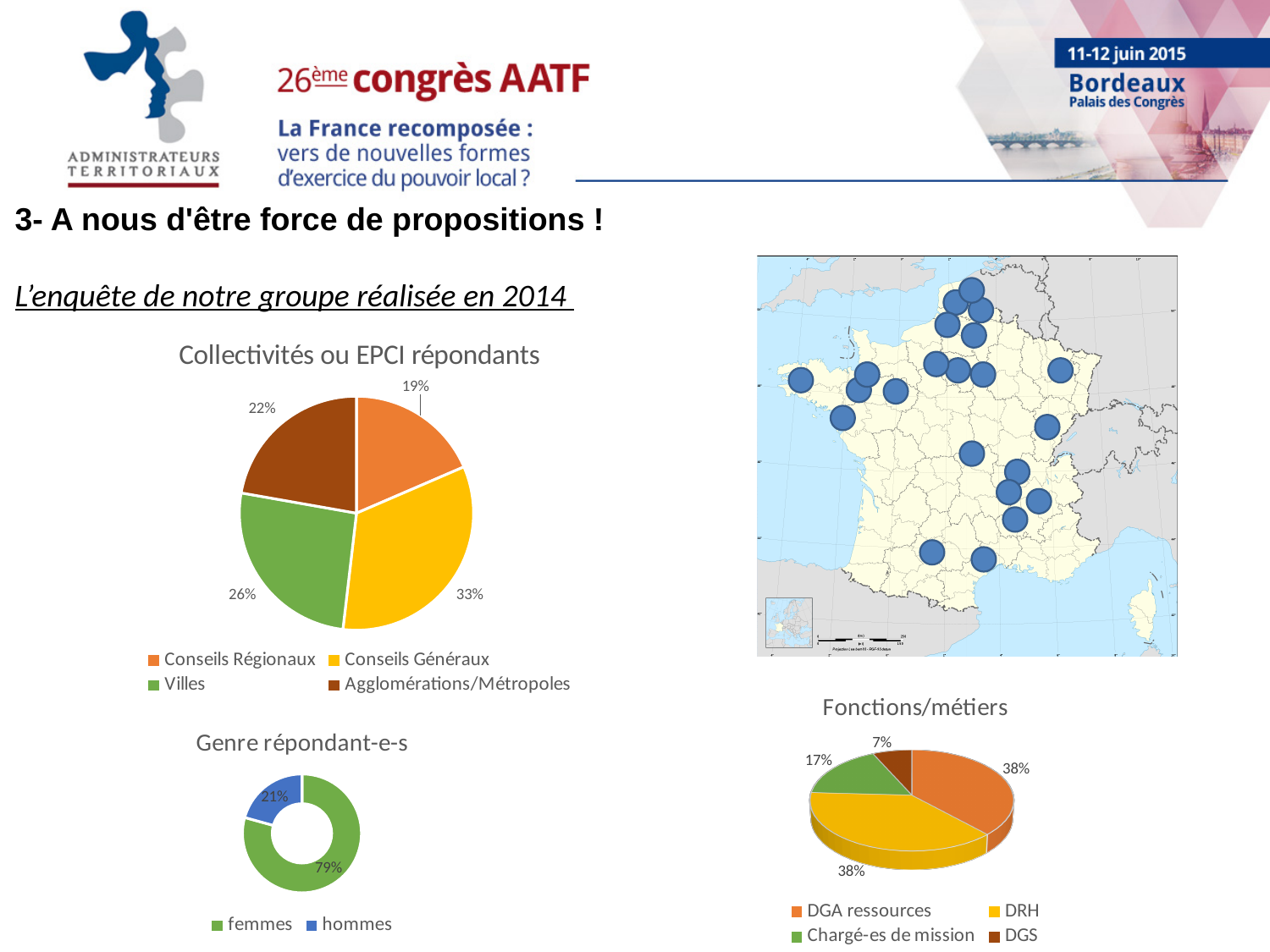
In the 'Fonctions/métiers' chart, what share is DGS? 7% How many categories does the 'Collectivités ou EPCI répondants' chart show? 4 In the 'Fonctions/métiers' chart, which is larger, DRH or Chargé-es de mission? DRH In the 'Collectivités ou EPCI répondants' chart, which category has the largest share? Conseils Généraux In the 'Collectivités ou EPCI répondants' chart, which category has the smallest share? Conseils Régionaux In the 'Genre répondant-e-s' chart, what share is hommes? 21% In the 'Collectivités ou EPCI répondants' chart, what share is Villes? 26% In the 'Fonctions/métiers' chart, what share is Chargé-es de mission? 17% In the 'Collectivités ou EPCI répondants' chart, what share is Conseils Généraux? 33% What kind of chart is 'Genre répondant-e-s'? Doughnut chart In the 'Genre répondant-e-s' chart, what share is femmes? 79% In the 'Collectivités ou EPCI répondants' chart, what is the difference between the Conseils Généraux share and the Agglomérations/Métropoles share? 11 percentage points